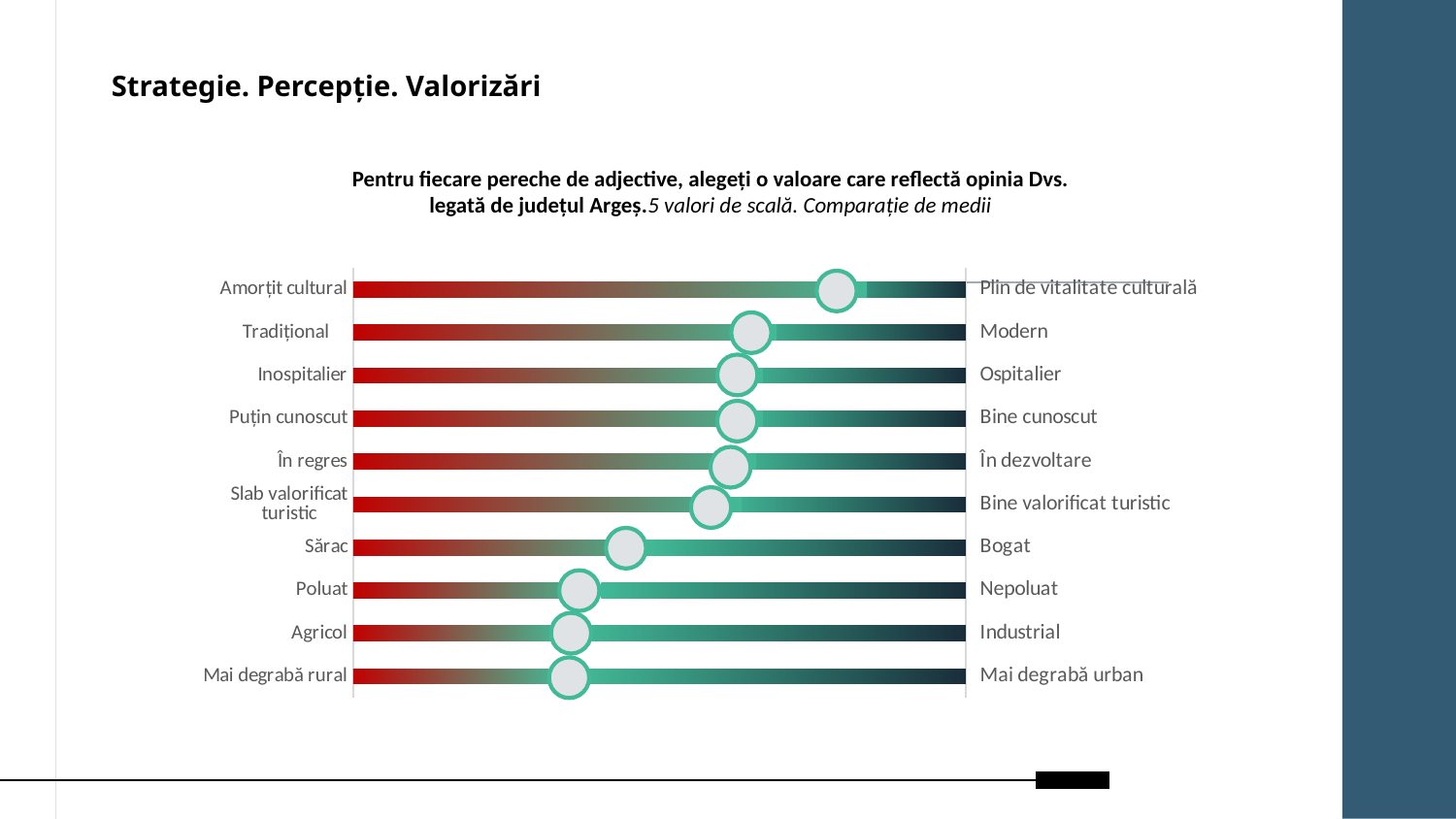
How many adjective pairs are plotted on the chart? 10 How many scale values does the chart subtitle say were used? 5 What is the left-hand adjective paired with 'Modern' on the chart? Tradițional Which marker is closer to the right-hand pole: Slab valorificat turistic – Bine valorificat turistic or Poluat – Nepoluat? Slab valorificat turistic – Bine valorificat turistic Is the marker for the pair Tradițional – Modern positioned further right than the marker for Sărac – Bogat? Yes What is the right-hand adjective paired with 'Sărac' on the chart? Bogat Which marker is closer to the left-hand pole: Agricol – Industrial or Inospitalier – Ospitalier? Agricol – Industrial Which adjective pair has its marker positioned furthest to the right, closest to the positive pole? Amorțit cultural – Plin de vitalitate culturală